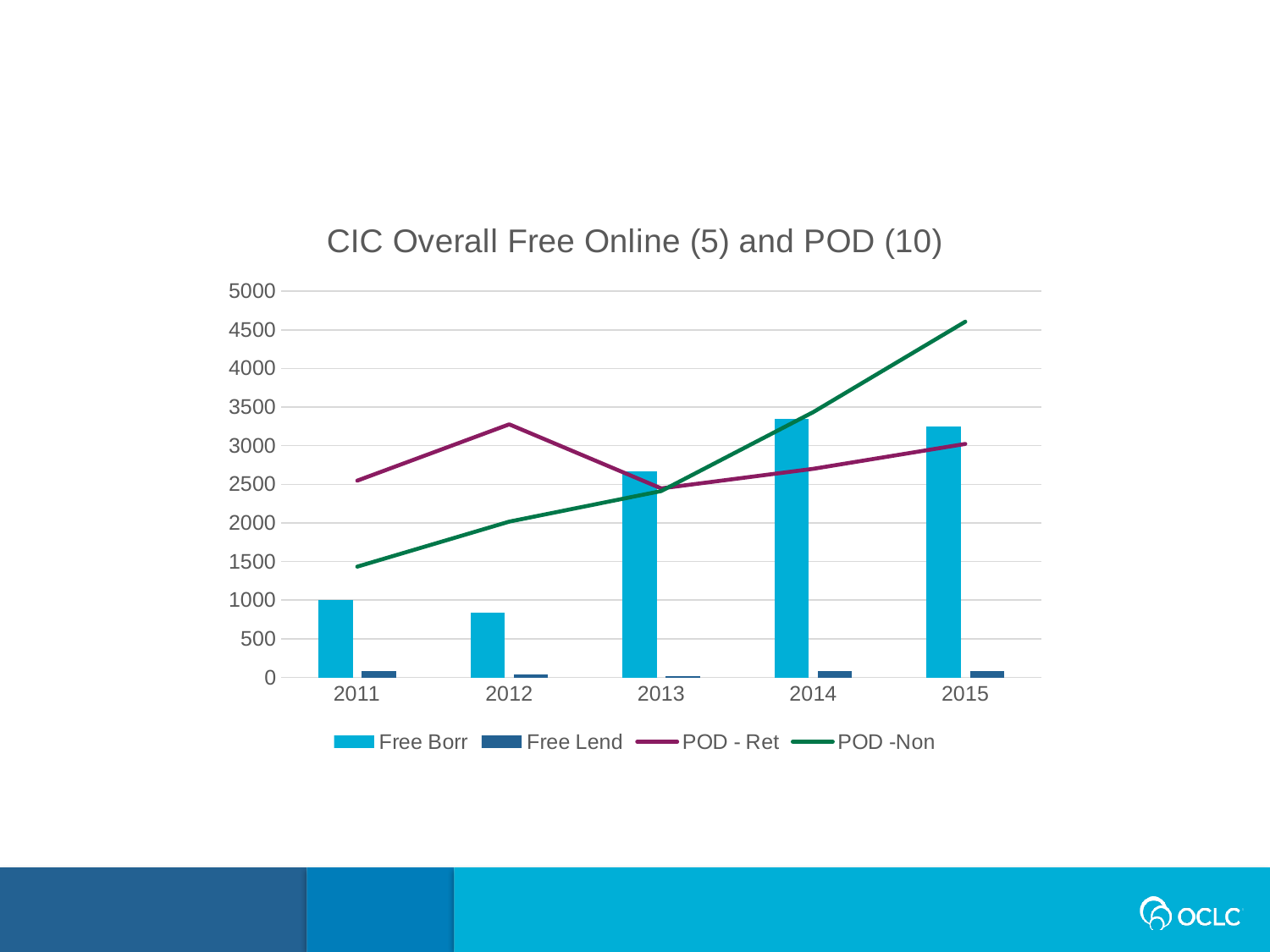
Is the POD -Non value for 2015 greater or less than 4500? greater In 2011, which is larger, POD - Ret or POD -Non? POD - Ret In which year does the POD -Non line reach its highest value? 2015 How many years are shown on the x axis? 5 In which year does the POD - Ret line reach its highest value? 2012 In which year is the Free Borr bar highest? 2014 How many series does the legend list? 4 In which year is the Free Borr bar lowest? 2012 What is the title of the chart? CIC Overall Free Online (5) and POD (10) Is the Free Borr value for 2012 greater or less than 1000? less Does the POD -Non line rise or fall from 2011 to 2015? rises Which series is drawn as a green line? POD -Non